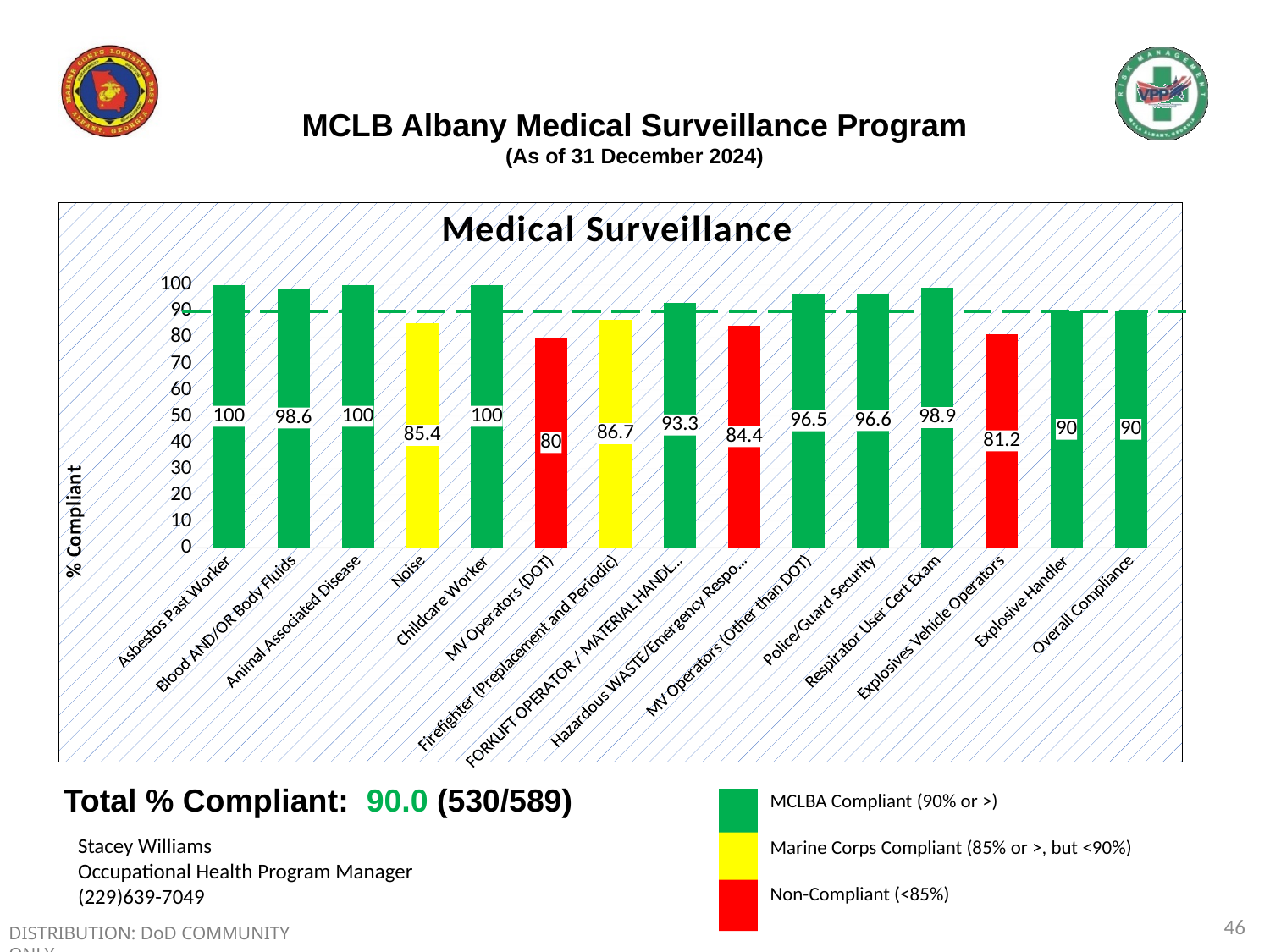
What is the difference between the values for Police/Guard Security and MV Operators (Other than DOT) in the Medical Surveillance chart? 0.1 What is the difference between the values for Blood AND/OR Body Fluids and Noise in the Medical Surveillance chart? 13.2 What is the value for Explosives Vehicle Operators in the Medical Surveillance chart? 81.2 Which is larger in the Medical Surveillance chart, the value for Firefighter (Preplacement and Periodic) or the value for MV Operators (DOT)? Firefighter (Preplacement and Periodic) What is the value for Overall Compliance in the Medical Surveillance chart? 90 How many categories in the Medical Surveillance chart have a value of 100? 3 What colour are the bars for categories that are Non-Compliant (<85%) in the Medical Surveillance chart? Red What kind of chart is the Medical Surveillance chart? Bar chart How many categories are shown on the x axis of the Medical Surveillance chart? 15 What is the value for Respirator User Cert Exam in the Medical Surveillance chart? 98.9 Which category has the lowest value in the Medical Surveillance chart? MV Operators (DOT) What is the value for Noise in the Medical Surveillance chart? 85.4